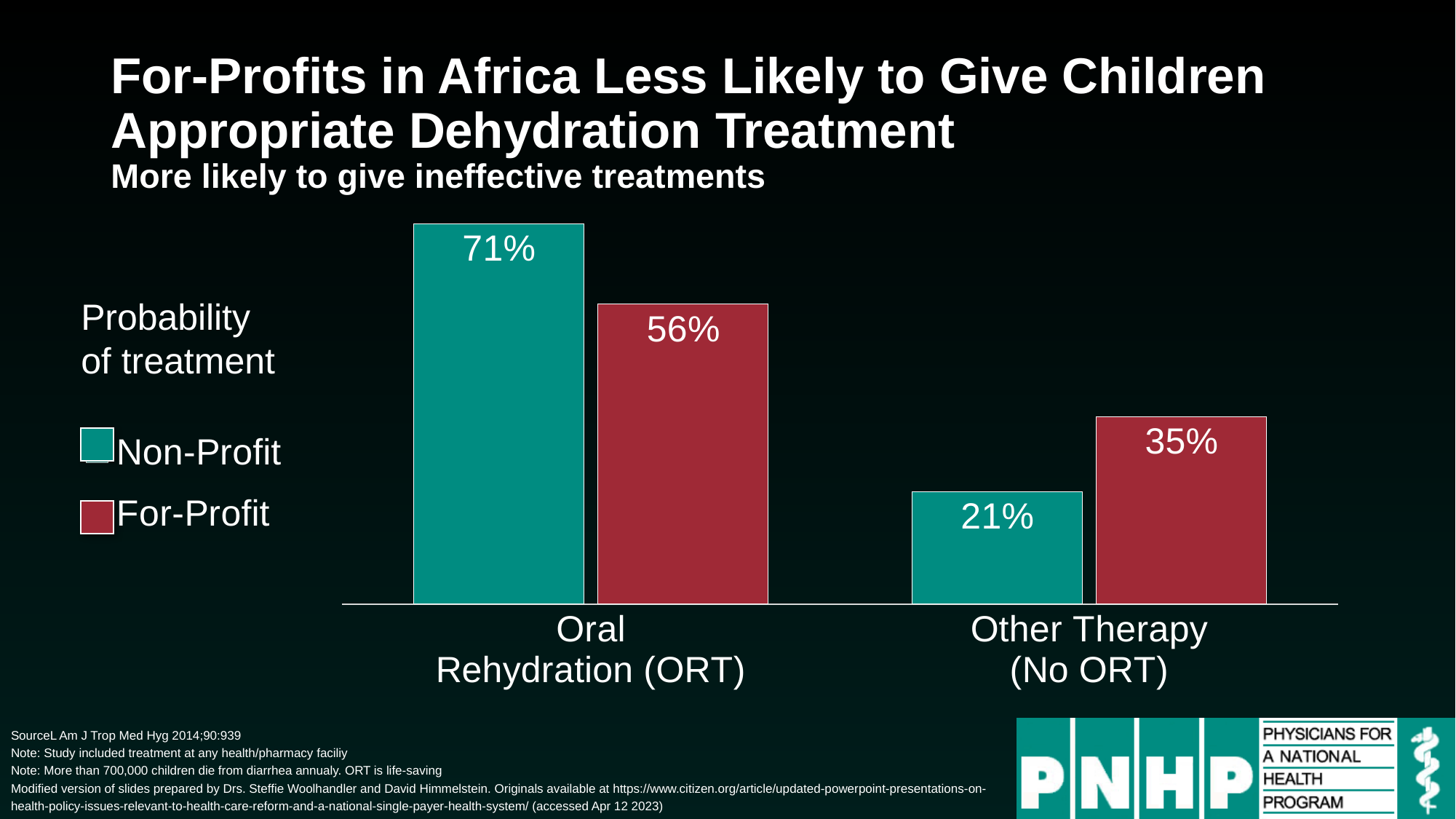
What is the difference between the For-Profit and Non-Profit values for Other Therapy (No ORT)? 14% What is the probability of treatment for For-Profit facilities under Oral Rehydration (ORT)? 56% What is the probability of treatment for Non-Profit facilities under Other Therapy (No ORT)? 21% Which bar shows the lowest probability of treatment on the chart? Non-Profit, Other Therapy (No ORT) For Other Therapy (No ORT), which is larger: the Non-Profit value or the For-Profit value? For-Profit What is the probability of treatment for For-Profit facilities under Other Therapy (No ORT)? 35% How many categories are shown on the x axis of the chart? 2 What is the difference between the Non-Profit and For-Profit values for Oral Rehydration (ORT)? 15% What kind of chart is shown on the slide? Bar chart How many series does the legend list? 2 Which bar shows the highest probability of treatment on the chart? Non-Profit, Oral Rehydration (ORT) What is the probability of treatment for Non-Profit facilities under Oral Rehydration (ORT)? 71%